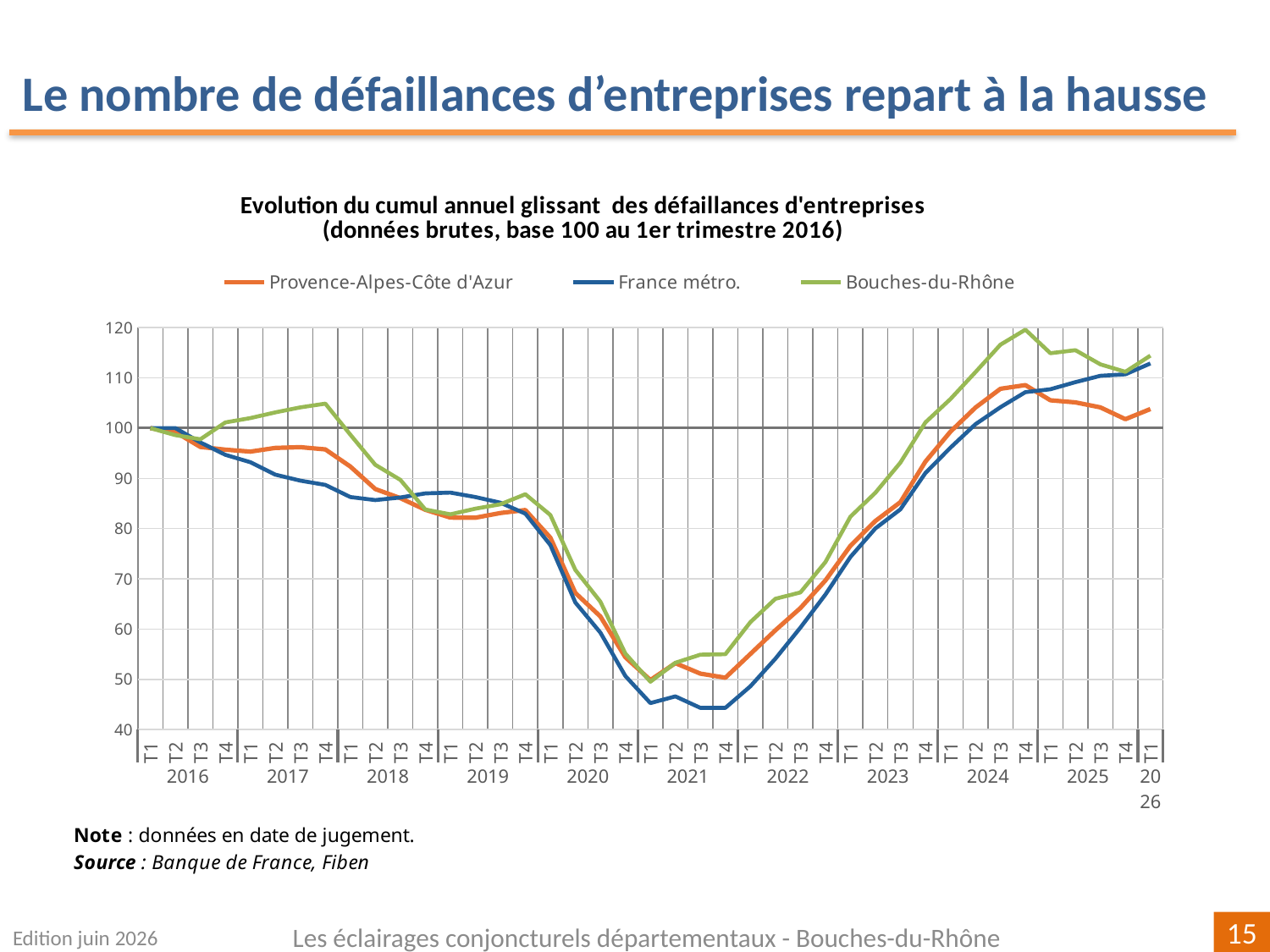
Which series has the highest value at T4 2024? Bouches-du-Rhône What kind of chart is shown on the slide? Line chart At T1 2026, which is higher: France métro. or Provence-Alpes-Côte d'Azur? France métro. How many years are labelled on the x axis? 11 Is the value for France métro. at T4 2021 greater or less than 50? less What is the value of the France métro. series at T1 2016? 100 Which series is drawn in green? Bouches-du-Rhône Is the value for France métro. at T1 2018 greater or less than 90? less Is the value for Bouches-du-Rhône at T4 2024 greater or less than 110? greater How many series does the legend list? 3 Do the values of the France métro. series rise or fall between T1 2020 and T4 2021? Fall Which series has the lowest value at T4 2021? France métro.